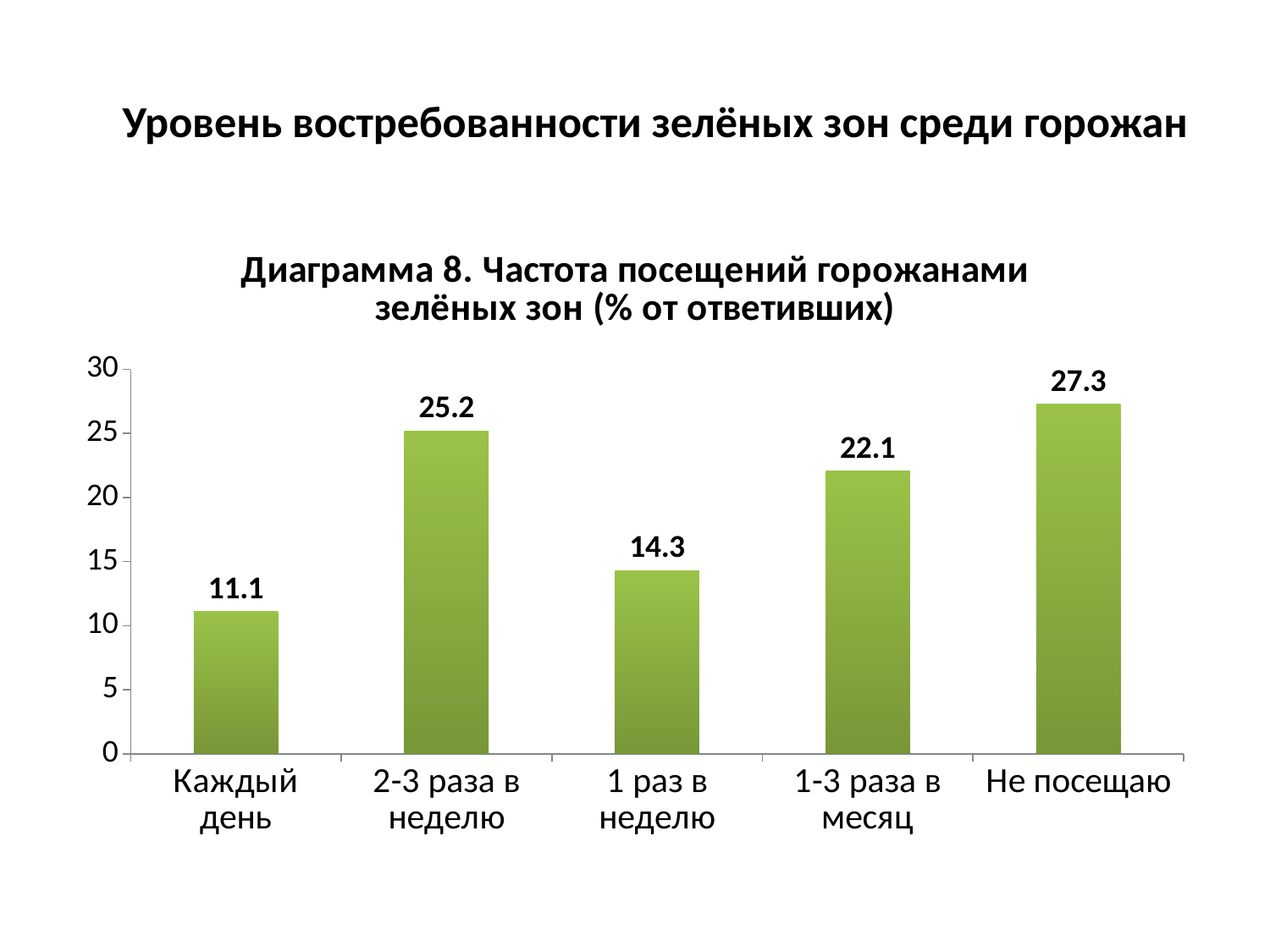
What is the difference between the values for "Не посещаю" and "Каждый день"? 16.2 Which category has the highest value? Не посещаю What is the value for "1-3 раза в месяц"? 22.1 Which category has the lowest value? Каждый день What is the value for "1 раз в неделю"? 14.3 How many categories are shown on the x axis? 5 What is the value for "2-3 раза в неделю"? 25.2 Which is larger, the value for "2-3 раза в неделю" or the value for "1-3 раза в месяц"? 2-3 раза в неделю What is the value for "Каждый день"? 11.1 What kind of chart is shown on the slide? bar chart Is the value for "1 раз в неделю" greater or less than 15? less What is the title of the chart? Диаграмма 8. Частота посещений горожанами зелёных зон (% от ответивших)